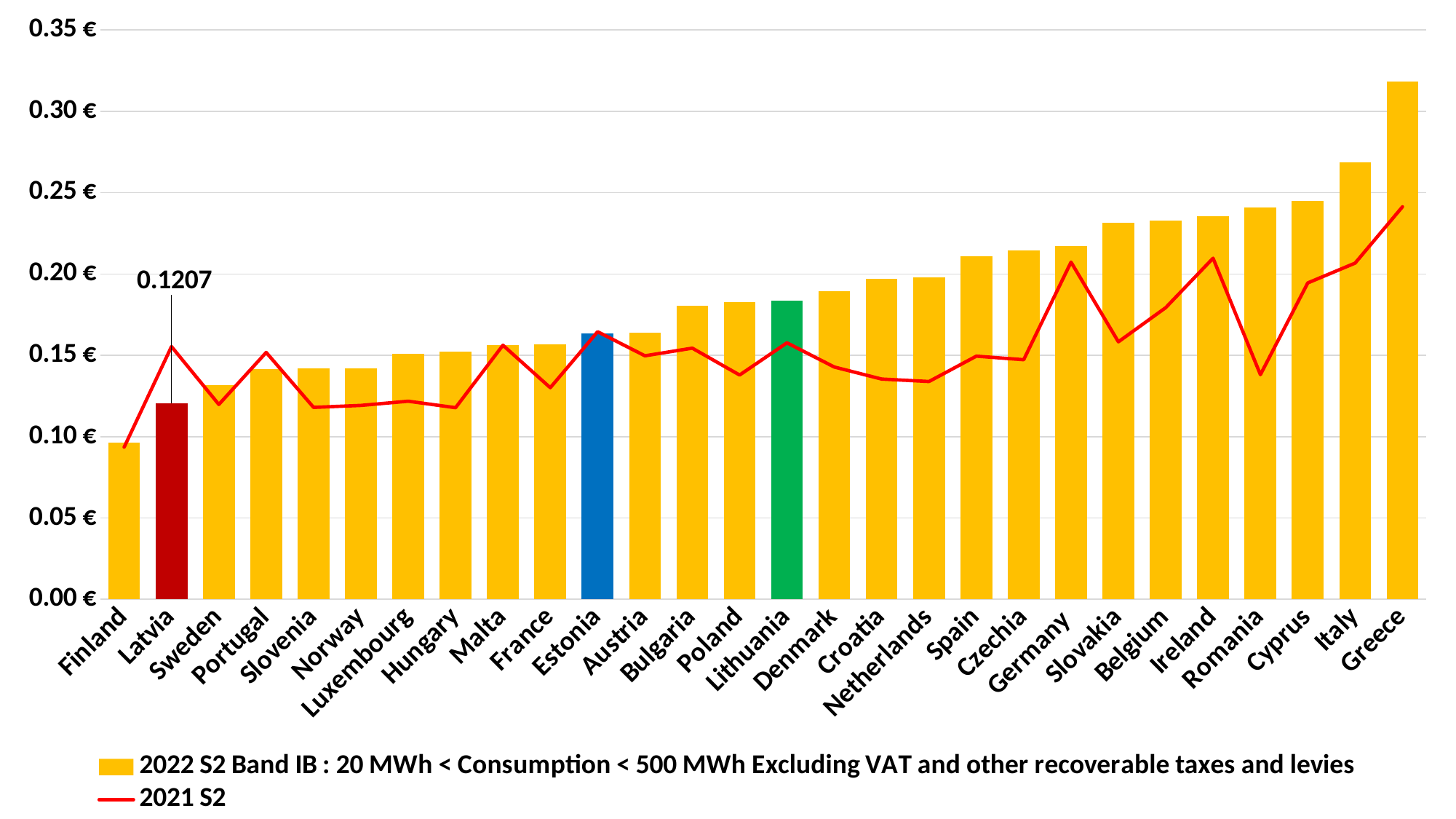
How many countries are shown on the x axis? 28 Do the 2022 S2 bars rise or fall from left to right along the x axis? rise Which has the larger 2022 S2 bar, Italy or Cyprus? Italy Is the 2022 S2 value for Greece greater or less than 0.30 €? greater What is the 2022 S2 value for Latvia? 0.1207 Which country has the highest 2022 S2 bar? Greece How many series does the legend list? 2 Is the 2022 S2 value for Germany greater or less than 0.20 €? greater What kind of chart is this? combination bar and line chart What colour is the bar for Latvia? red Which country has the lowest 2022 S2 bar? Finland